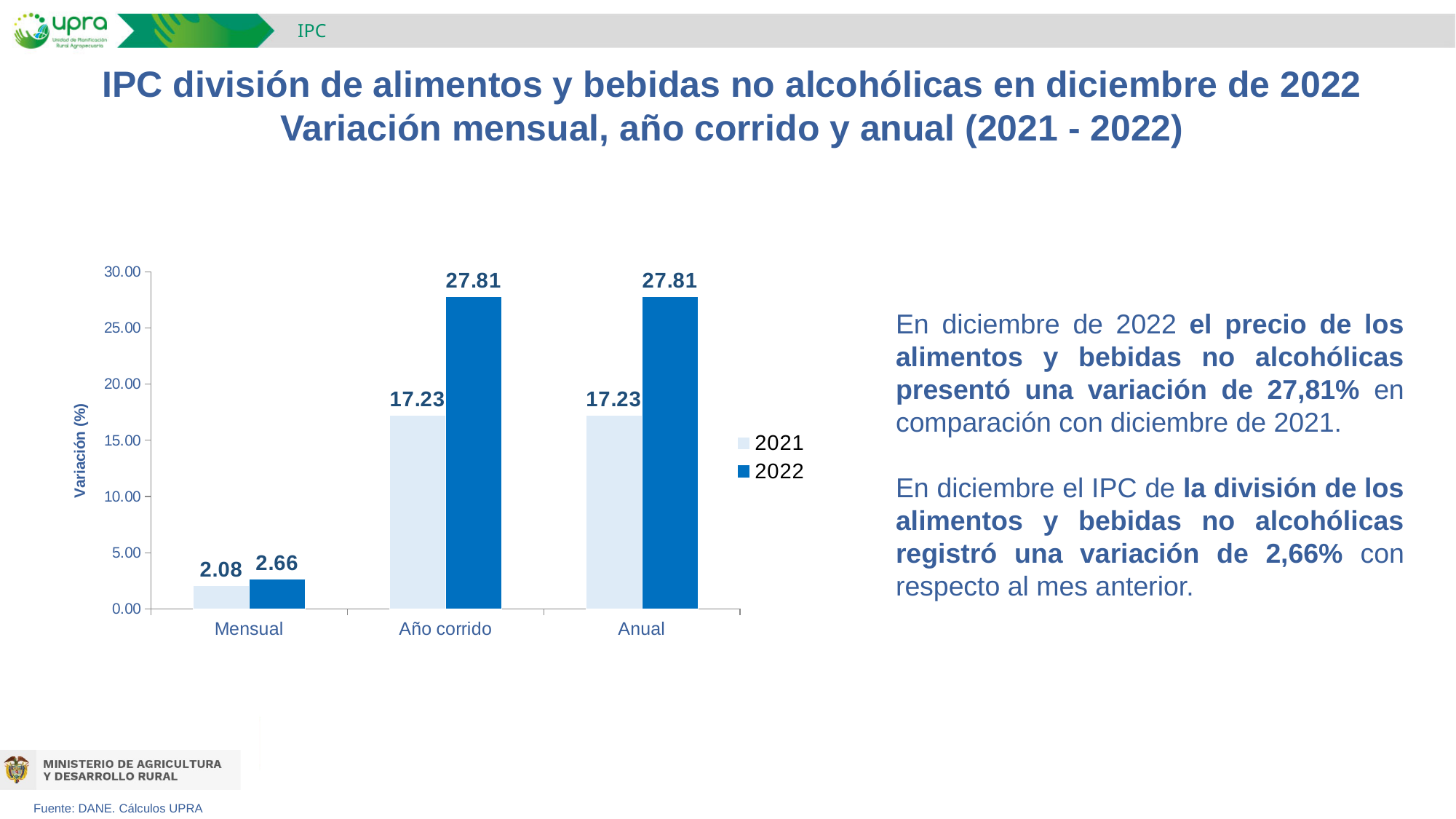
What is the difference between the 2022 and 2021 values for Mensual? 0.58 What is the 2022 value for Mensual? 2.66 What kind of chart is shown on the slide? Bar chart What is the 2021 value for Año corrido? 17.23 How many categories are shown on the x axis? 3 What is the difference between the 2022 and 2021 values for Año corrido? 10.58 How many series does the legend list? 2 What is the 2022 value for Anual? 27.81 Which category has the lowest 2022 value? Mensual Is the 2021 value for Anual greater or less than 15.00? greater Which is larger for Anual, the 2021 value or the 2022 value? 2022 What is the label of the vertical axis? Variación (%)